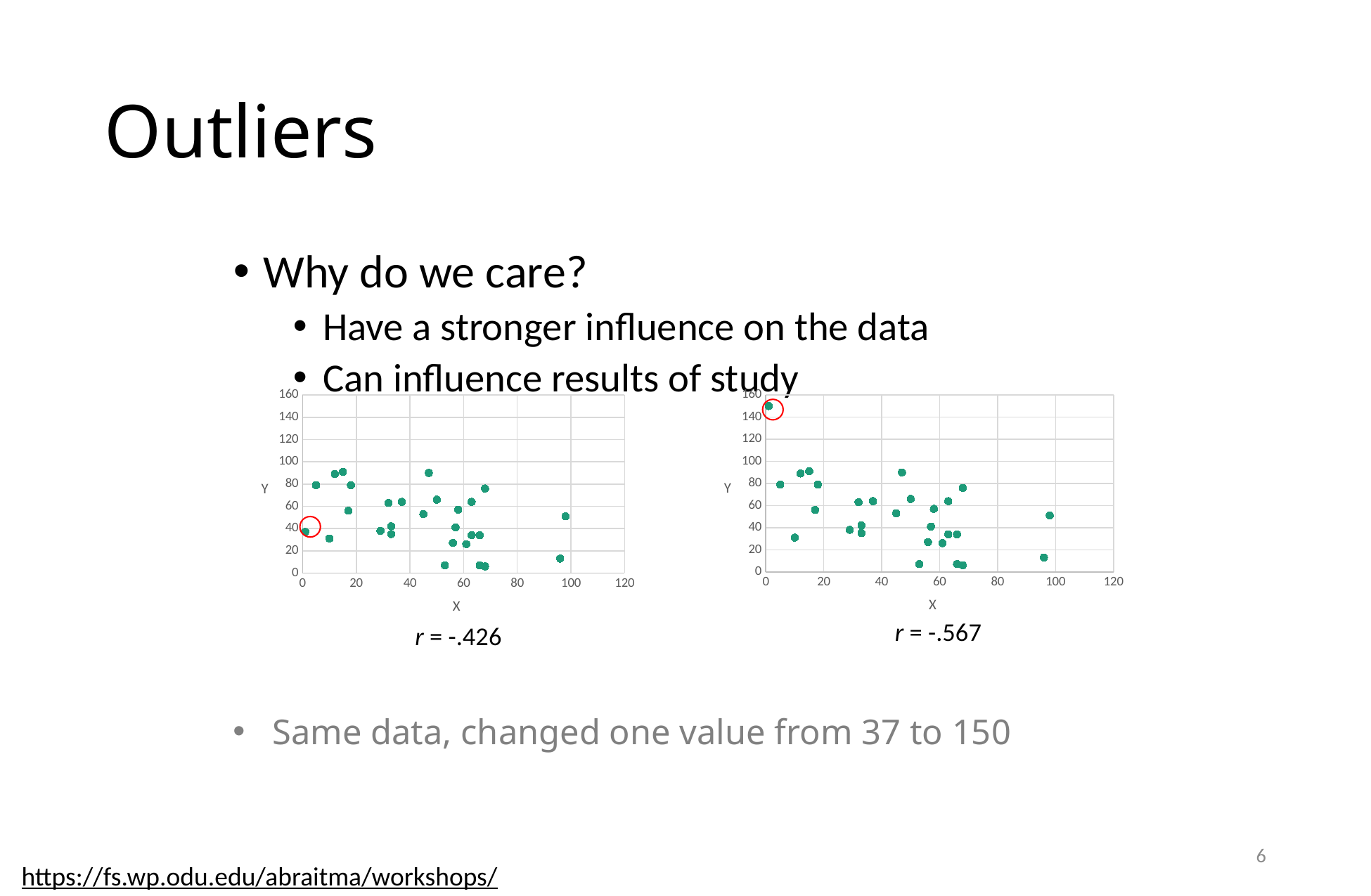
What kind of chart is the left chart? scatter plot In the left chart, is the Y value of the lowest point near X = 96 greater or less than 20? less What is the correlation coefficient r shown under the right chart? r = -.567 What is the correlation coefficient r shown under the left chart? r = -.426 What is the maximum value shown on the X axis of the right chart? 120 In the right chart, is the value of the circled point greater or less than 140? greater In the right chart, is the circled point the highest point on the chart? yes What kind of chart is the right chart? scatter plot